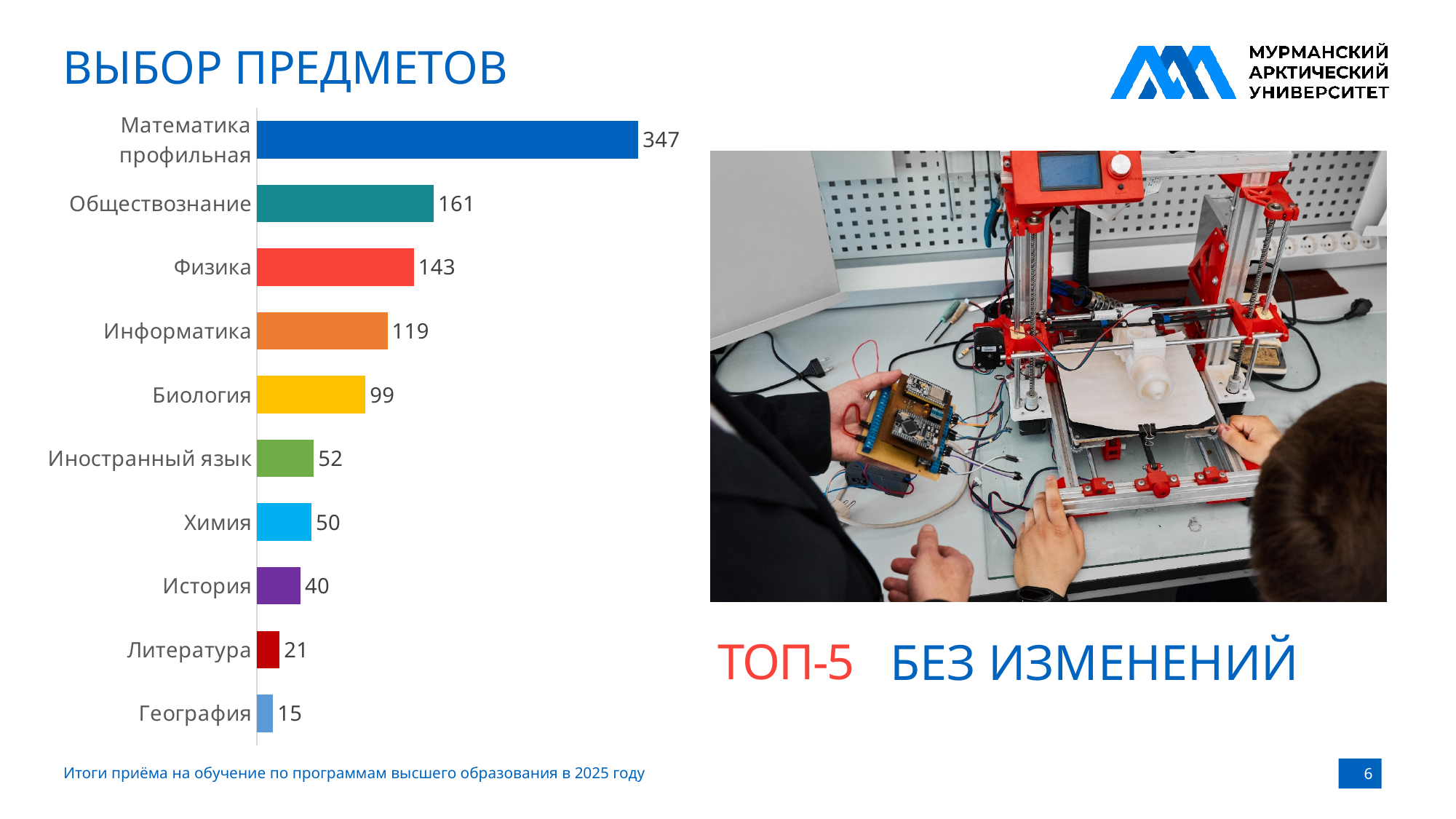
Which has a larger value, Иностранный язык or История? Иностранный язык What is the title of the chart on the slide? ВЫБОР ПРЕДМЕТОВ What is the difference between the values for Математика профильная and Биология? 248 Which subject has the lowest value? География Which subject has the highest value? Математика профильная How many subjects are shown in the chart? 10 Which has a larger value, Литература or Биология? Биология What is the difference between the values for Обществознание and Физика? 18 What kind of chart is shown on the slide? Bar chart What is the value for Химия? 50 What is the value for Информатика? 119 What is the value for Математика профильная? 347